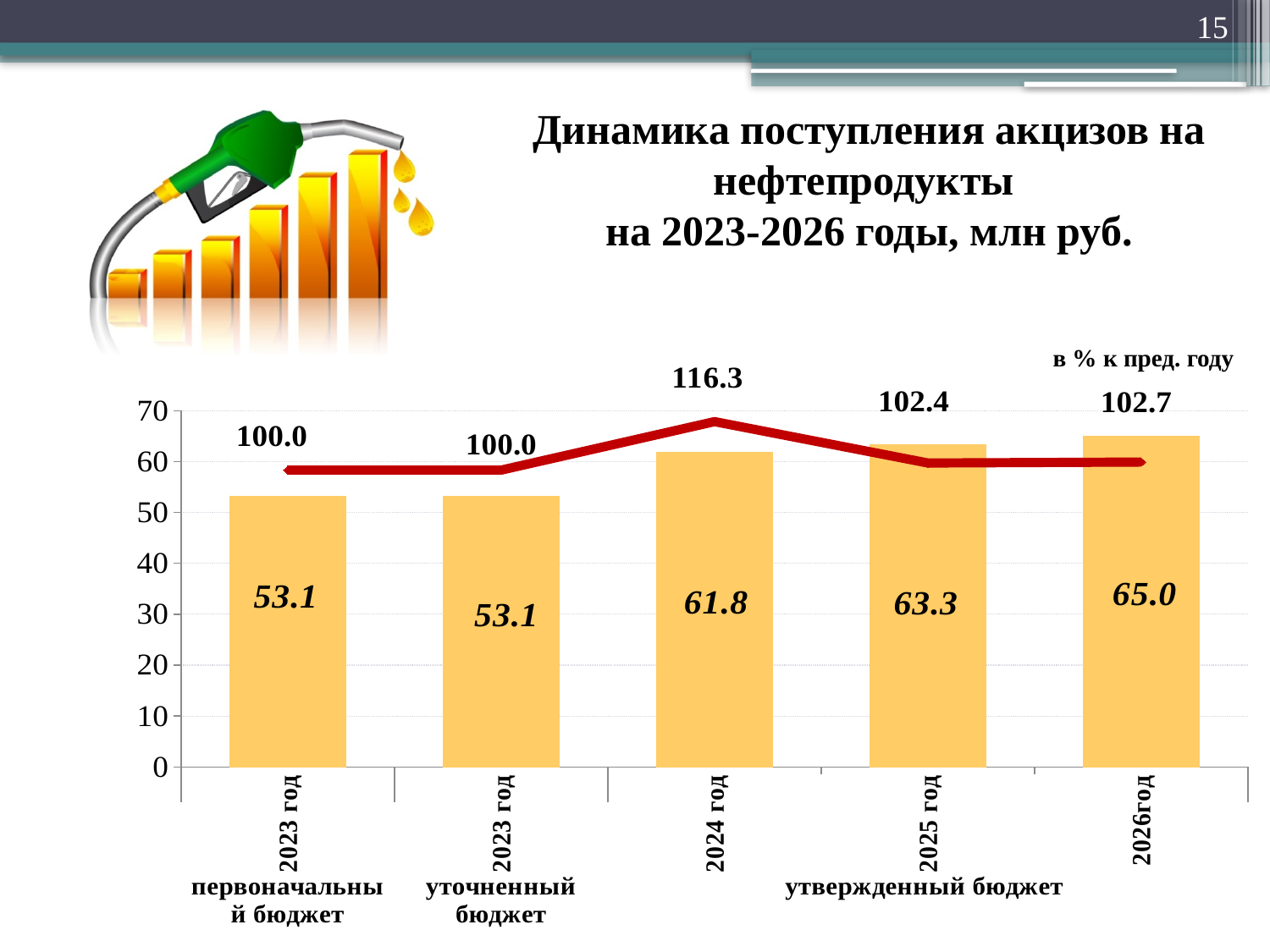
What is the value of the bar for 2024 год? 61.8 What is the difference between the bar values for 2026 год and 2025 год? 1.7 What is the value of the bar for 2023 год (уточненный бюджет)? 53.1 Which year has the highest bar value? 2026 год How many bars are shown in the chart? 5 What is the line value (в % к пред. году) for 2025 год? 102.4 Do the bar values rise or fall from 2024 год to 2026 год? rise Which is larger, the bar value for 2025 год or for 2024 год? 2025 год Which year has the highest line value (в % к пред. году)? 2024 год What is the difference between the bar values for 2024 год and 2023 год (уточненный бюджет)? 8.7 What is the line value (в % к пред. году) for 2024 год? 116.3 What is the value of the bar for 2026 год? 65.0